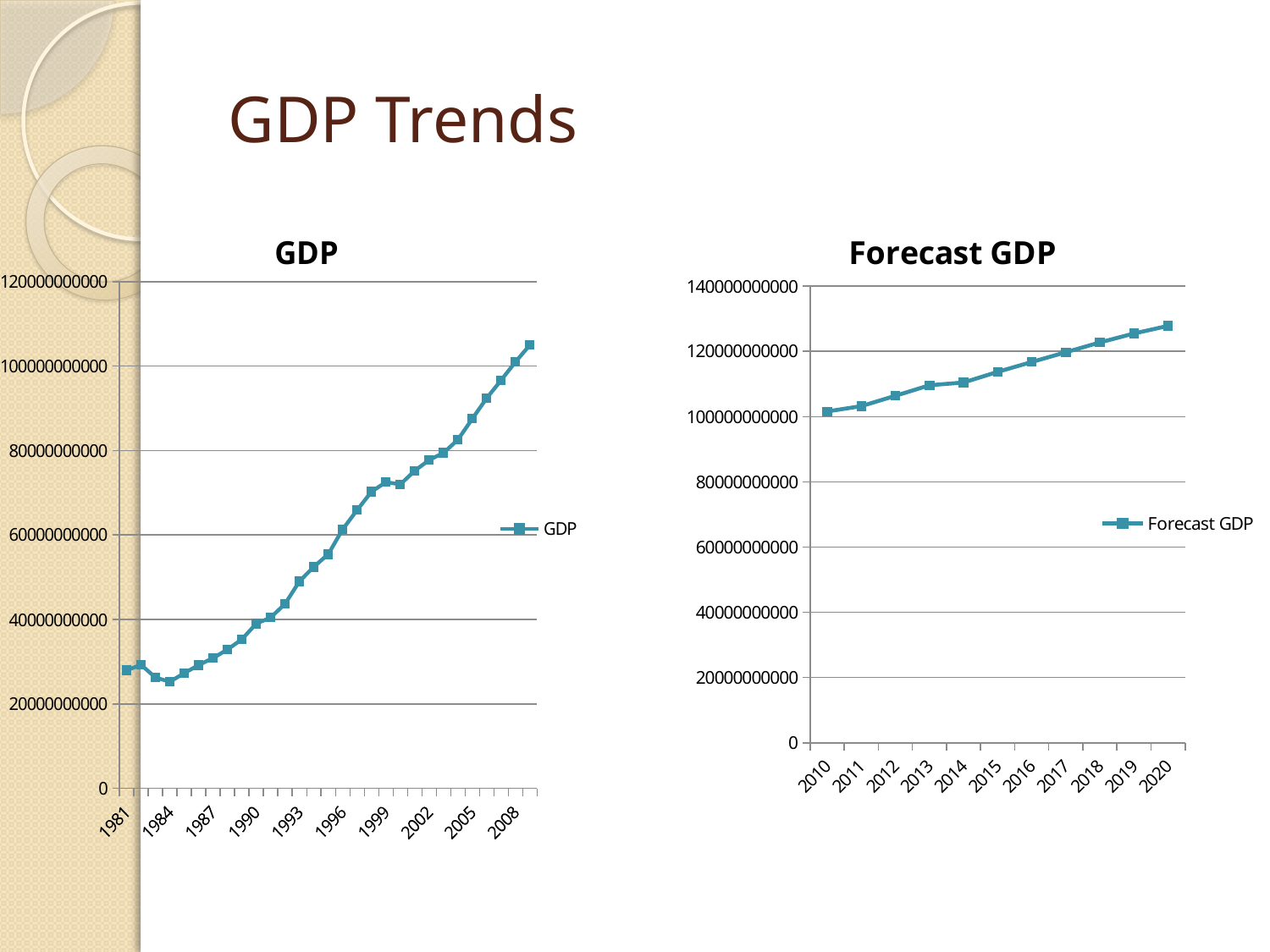
What kind of chart is the 'Forecast GDP' chart on the right? line chart In the 'Forecast GDP' chart, do the values rise or fall from 2010 to 2020? rise In the 'Forecast GDP' chart, which year has the highest value? 2020 In the 'GDP' chart, is the value for 1981 greater or less than 20000000000? greater In the 'Forecast GDP' chart, how many years are plotted on the x axis? 11 In the 'Forecast GDP' chart, which year has the lowest value? 2010 In the 'GDP' chart, is the value for 1999 greater or less than 80000000000? less What kind of chart is the 'GDP' chart on the left? line chart How many series does the legend of the 'GDP' chart list? 1 In the 'GDP' chart, which labeled year has the lowest value? 1984 In the 'GDP' chart, which year has the larger value, 1993 or 2005? 2005 In the 'Forecast GDP' chart, is the value for 2020 greater or less than 120000000000? greater